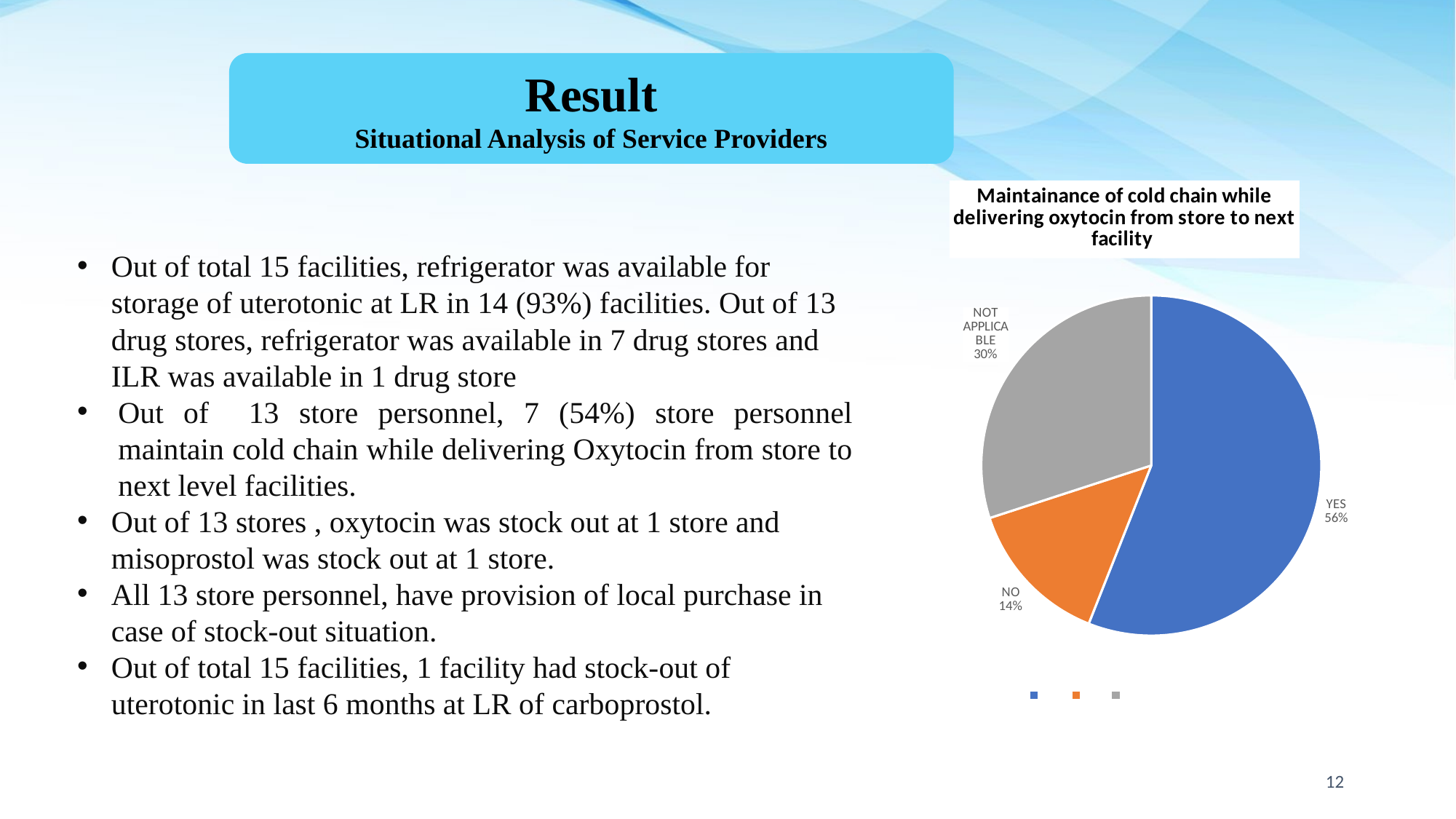
What share of the pie is labelled NO? 14% What is the difference in percentage points between the YES and NO slices? 42 How many slices does the pie chart have? 3 What kind of chart is shown on the slide? pie chart What share of the pie is labelled NOT APPLICABLE? 30% Which slice of the pie is the smallest? NO What colour is the YES slice of the pie? blue What share of the pie is labelled YES? 56% What is the difference in percentage points between the YES and NOT APPLICABLE slices? 26 Which is larger, the NOT APPLICABLE slice or the NO slice? NOT APPLICABLE What is the title of the pie chart? Maintainance of cold chain while delivering oxytocin from store to next facility Which slice of the pie is the largest? YES